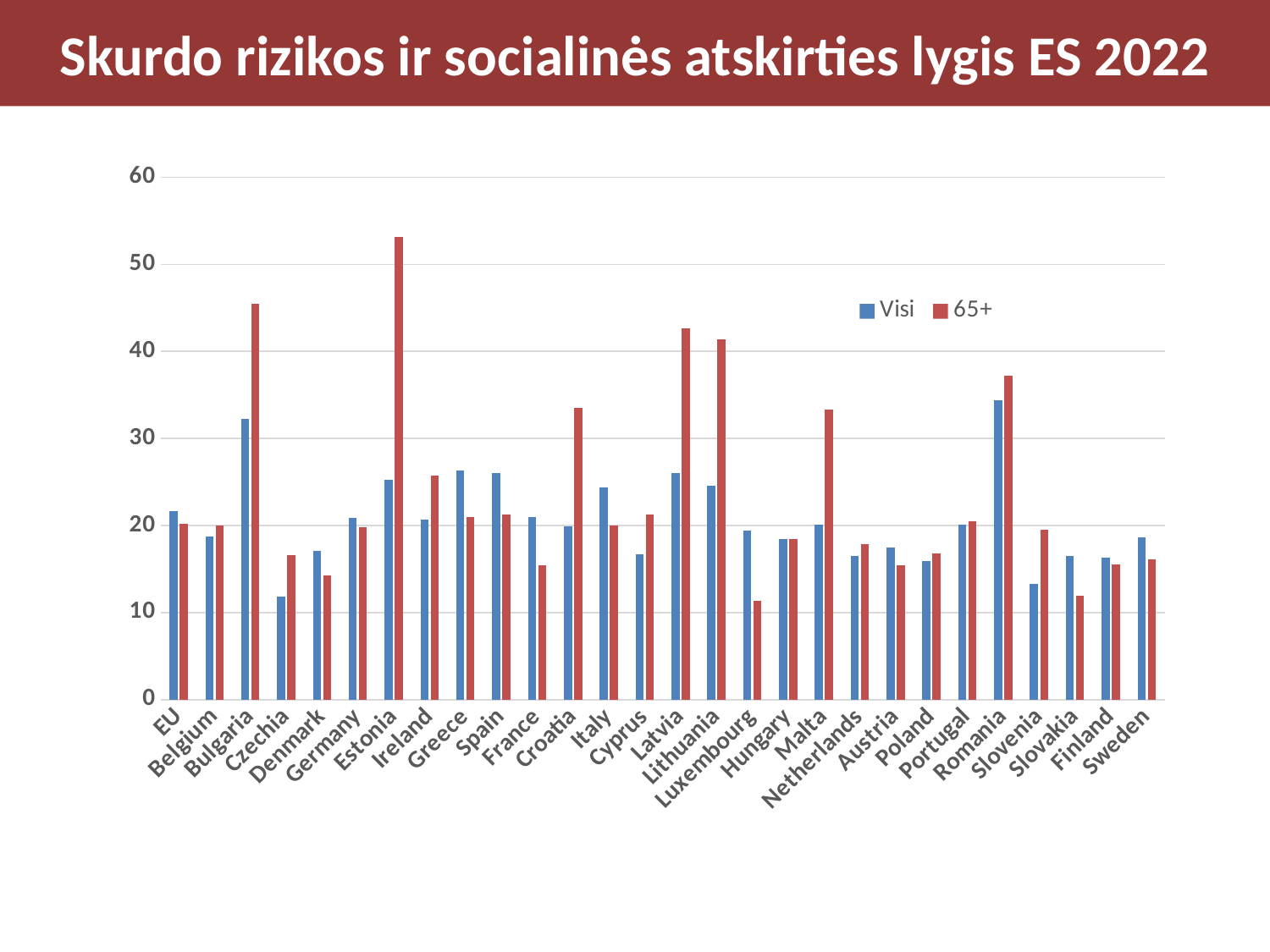
Is the 65+ value for Malta greater or less than 30? greater How many series does the legend list? 2 Which category has the highest value for the Visi series? Romania Which category has the highest value for the 65+ series? Estonia What type of chart is shown on the slide? bar chart For Greece, which series has the larger value, Visi or 65+? Visi Which category has the lowest value for the Visi series? Czechia For Bulgaria, which series has the larger value, Visi or 65+? 65+ What are the names of the two series in the legend? Visi and 65+ How many countries/categories are shown on the x axis? 28 Is the 65+ value for Estonia greater or less than 50? greater Is the Visi value for Czechia greater or less than 20? less